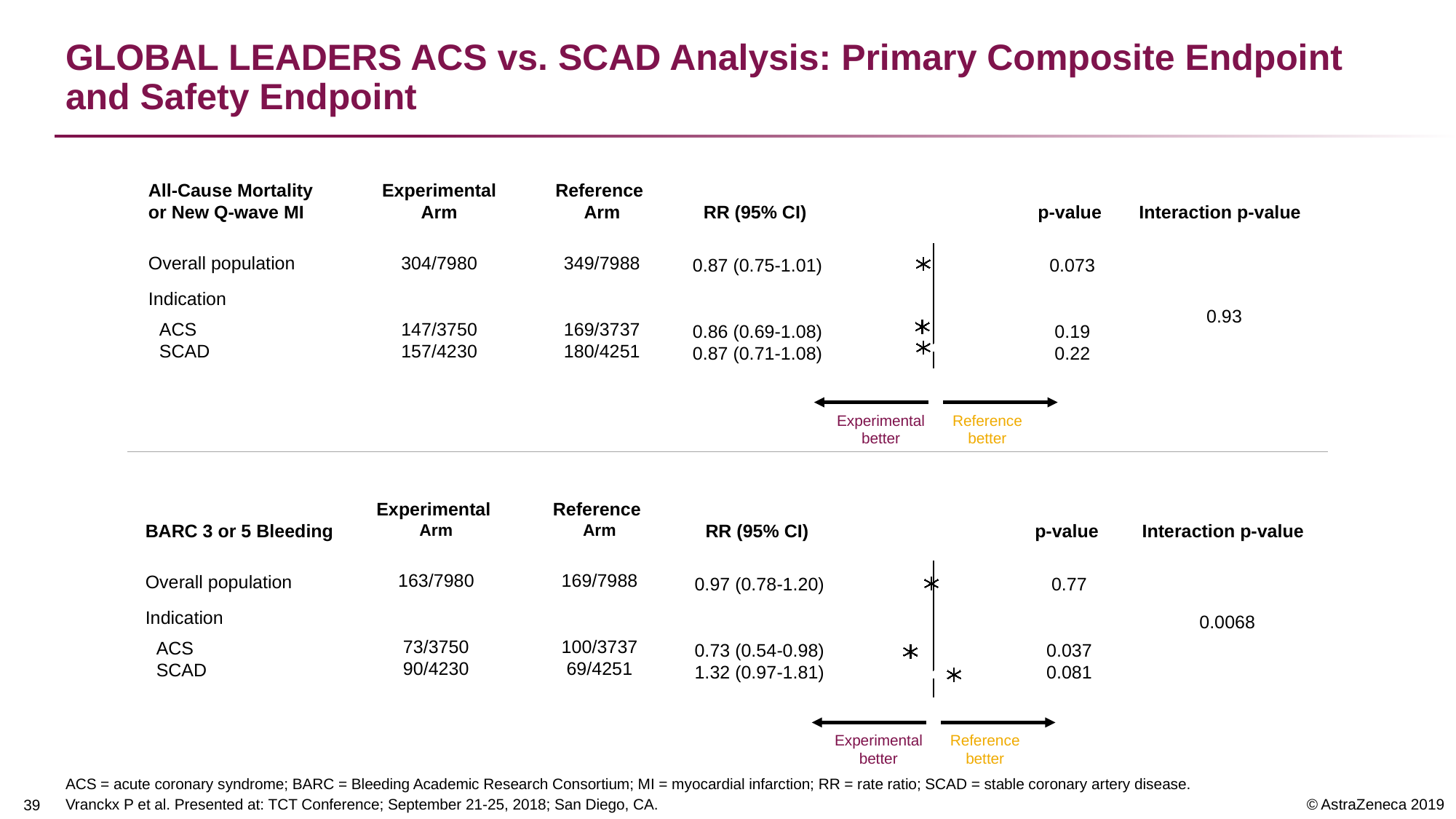
In the BARC 3 or 5 Bleeding forest plot, what is the interaction p-value? 0.0068 In the BARC 3 or 5 Bleeding forest plot, which row has the highest rate ratio? SCAD In the BARC 3 or 5 Bleeding forest plot, what is the RR (95% CI) for ACS? 0.73 (0.54-0.98) In the BARC 3 or 5 Bleeding forest plot, what does the label under the left-pointing arrow say? Experimental better In the All-Cause Mortality or New Q-wave MI forest plot, what is the interaction p-value? 0.93 What kind of chart is used on this slide to display the rate ratios? Forest plot In the BARC 3 or 5 Bleeding forest plot, which row has the lowest rate ratio? ACS How many rows (point estimates) are plotted in the All-Cause Mortality or New Q-wave MI forest plot? 3 In the BARC 3 or 5 Bleeding forest plot, which indication has the higher rate ratio, ACS or SCAD? SCAD In the BARC 3 or 5 Bleeding forest plot, is the rate ratio for SCAD greater or less than 1? greater In the BARC 3 or 5 Bleeding forest plot, what is the p-value for SCAD? 0.081 In the All-Cause Mortality or New Q-wave MI forest plot, what is the RR (95% CI) for the overall population? 0.87 (0.75-1.01)